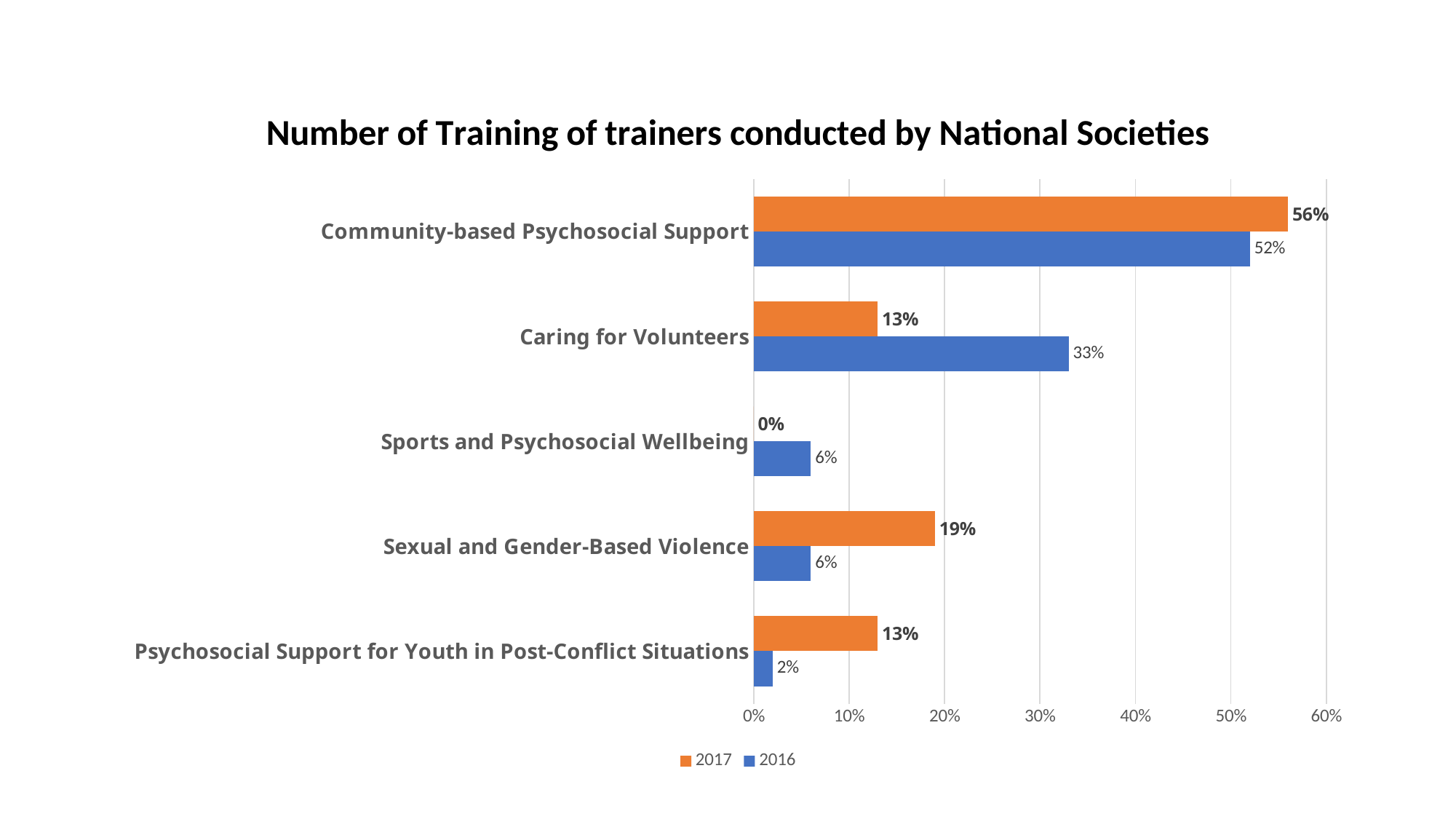
Which is larger for Sexual and Gender-Based Violence, the 2017 value or the 2016 value? 2017 How many series does the legend list? 2 What is the 2016 value for Caring for Volunteers? 33% How many categories are shown on the chart? 5 What is the 2016 value for Psychosocial Support for Youth in Post-Conflict Situations? 2% What is the difference between the 2016 and 2017 values for Caring for Volunteers? 20% Is the 2016 value for Community-based Psychosocial Support greater or less than 40%? greater What is the 2017 value for Community-based Psychosocial Support? 56% What is the 2017 value for Sports and Psychosocial Wellbeing? 0% What type of chart is shown on the slide? Bar chart Which category has the lowest 2017 value? Sports and Psychosocial Wellbeing Which category has the highest 2016 value? Community-based Psychosocial Support